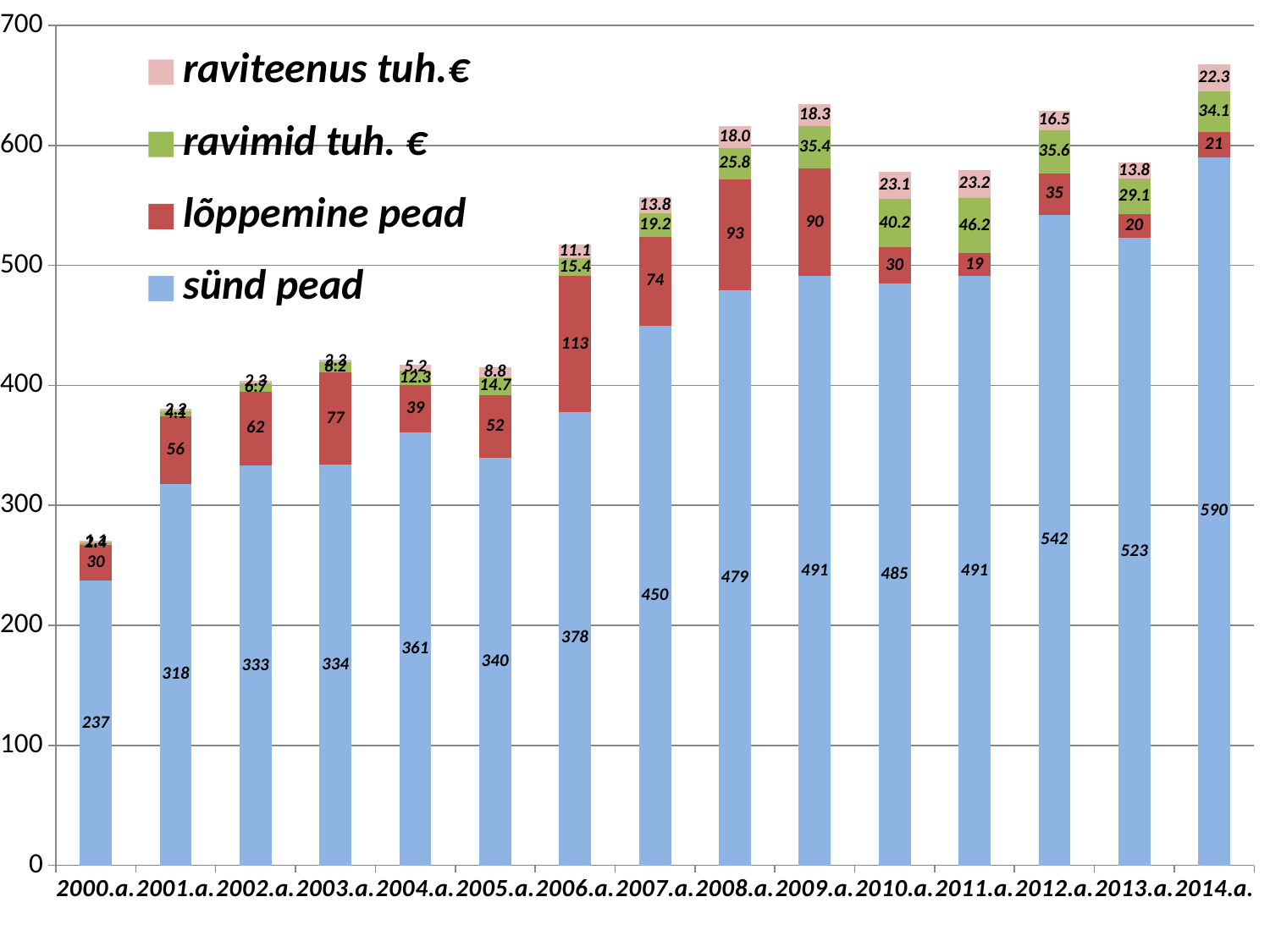
What kind of chart is shown on the slide? Stacked bar chart What is the value of ravimid tuh. € for 2011.a.? 46.2 What is the total of the stacked bar for 2014.a.? 667.4 What is the value of sünd pead for 2014.a.? 590 How many series does the legend list? 4 Which year has the lowest value for sünd pead? 2000.a. Which year has the highest value for sünd pead? 2014.a. Which is larger, the lõppemine pead value for 2008.a. or for 2009.a.? 2008.a. What is the difference between the sünd pead values for 2014.a. and 2013.a.? 67 How many years are shown on the x axis? 15 What is the value of raviteenus tuh.€ for 2009.a.? 18.3 What is the value of lõppemine pead for 2006.a.? 113